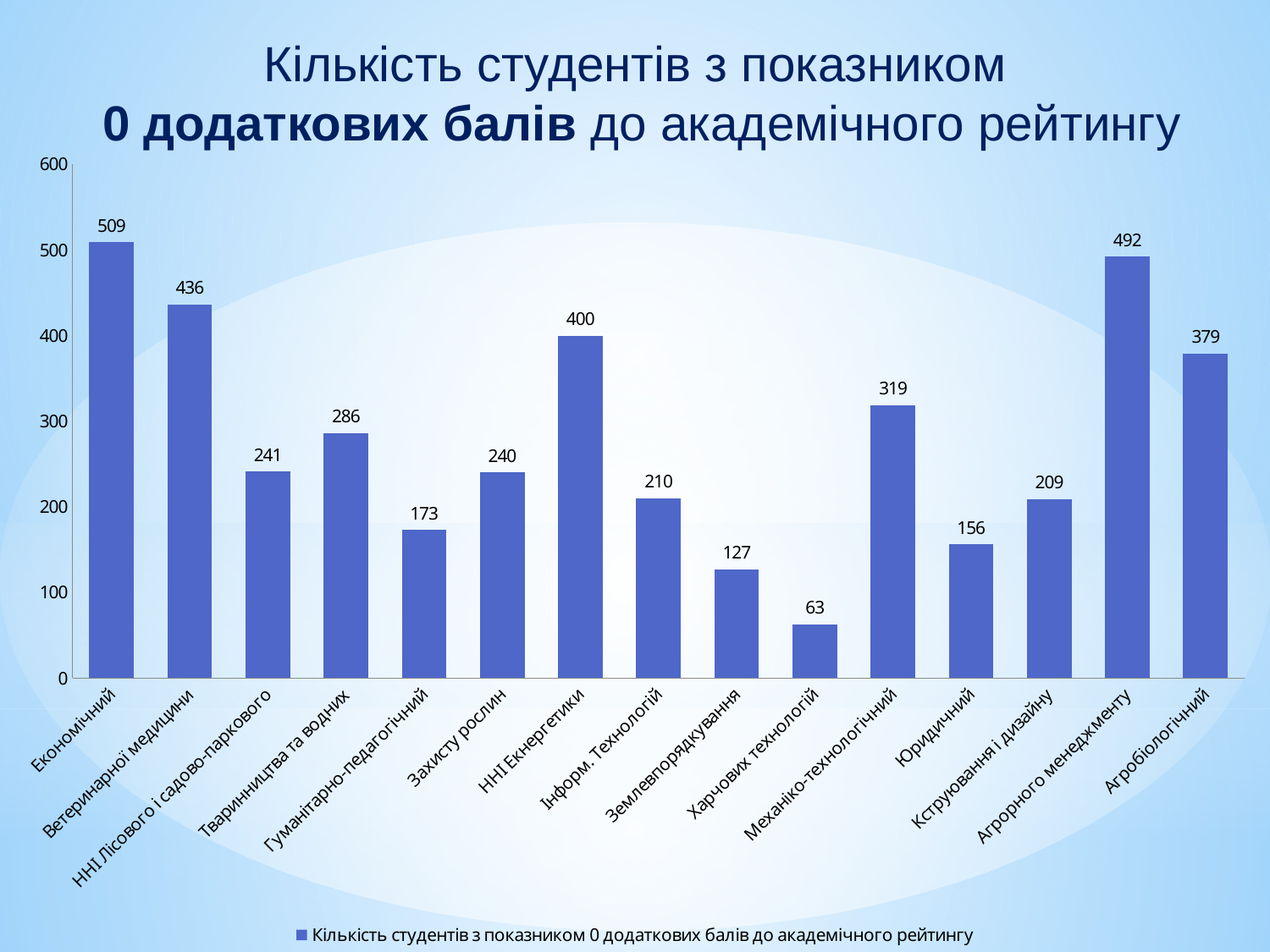
Which category has the highest value? Економічний What is the difference between the values for Економічний and Агрорного менеджменту? 17 How many categories are shown on the x axis? 15 Which is larger, the value for Ветеринарної медицини or the value for ННІ Екнергетики? Ветеринарної медицини What is the value for Харчових технологій? 63 Is the value for Агробіологічний greater or less than 300? greater What is the difference between the values for Юридичний and Землевпорядкування? 29 How many series does the legend list? 1 Which category has the lowest value? Харчових технологій What is the value for Механіко-технологічний? 319 What kind of chart is shown on the slide? bar chart What is the value for Економічний? 509